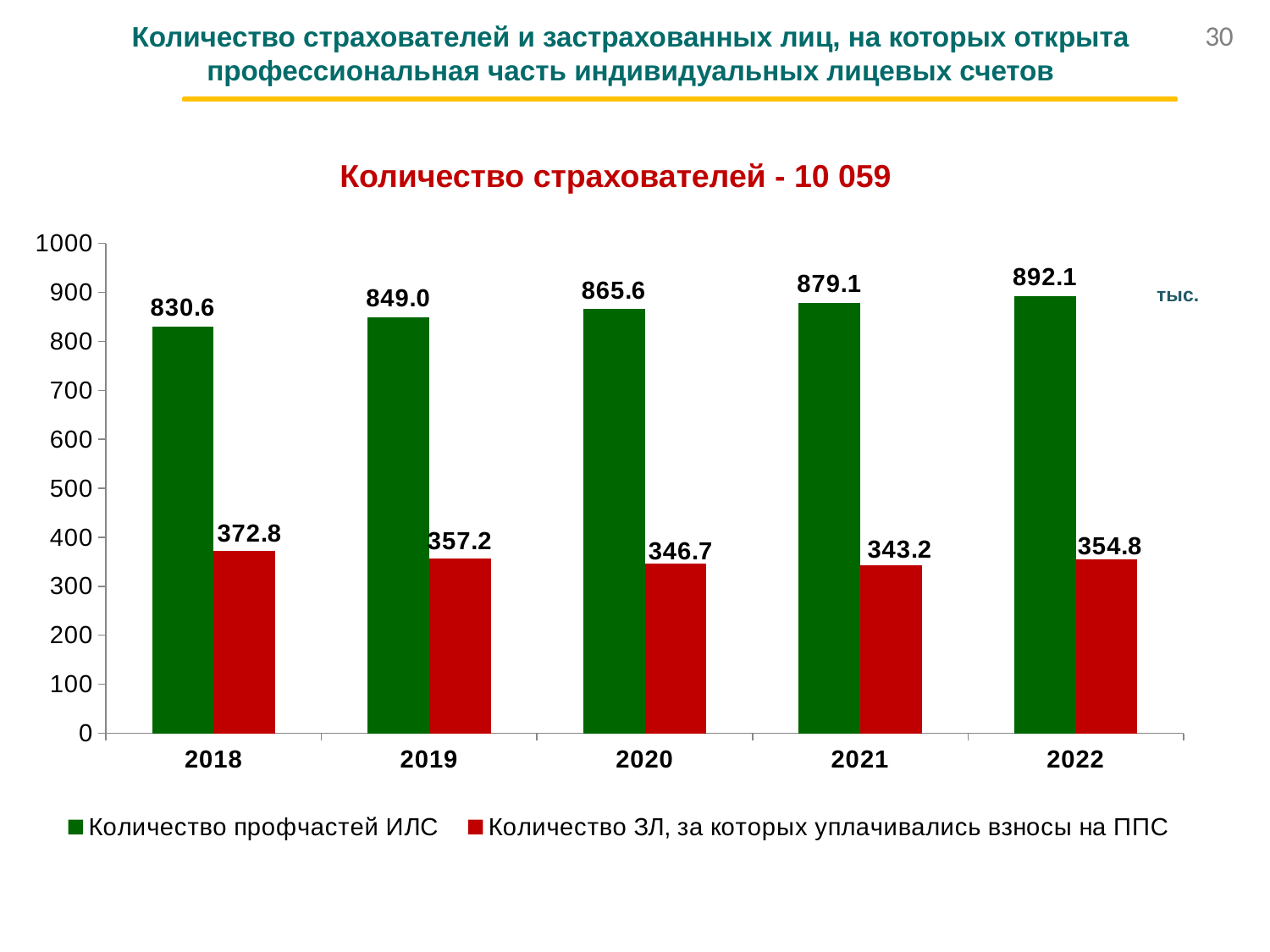
Which is larger: 'Количество ЗЛ, за которых уплачивались взносы на ППС' in 2019 or in 2022? 2019 What is the value of 'Количество ЗЛ, за которых уплачивались взносы на ППС' for 2018? 372.8 Is the value of 'Количество профчастей ИЛС' for 2021 greater or less than 800? greater What colour are the bars for 'Количество профчастей ИЛС'? green Does 'Количество профчастей ИЛС' rise or fall from 2018 to 2022? rise In which year is 'Количество ЗЛ, за которых уплачивались взносы на ППС' lowest? 2021 What kind of chart is shown on the slide? bar chart What is the value of 'Количество профчастей ИЛС' for 2020? 865.6 In which year is 'Количество профчастей ИЛС' highest? 2022 How many years are shown on the x axis? 5 What is the difference between 'Количество профчастей ИЛС' in 2022 and in 2018? 61.5 How many series does the legend list? 2